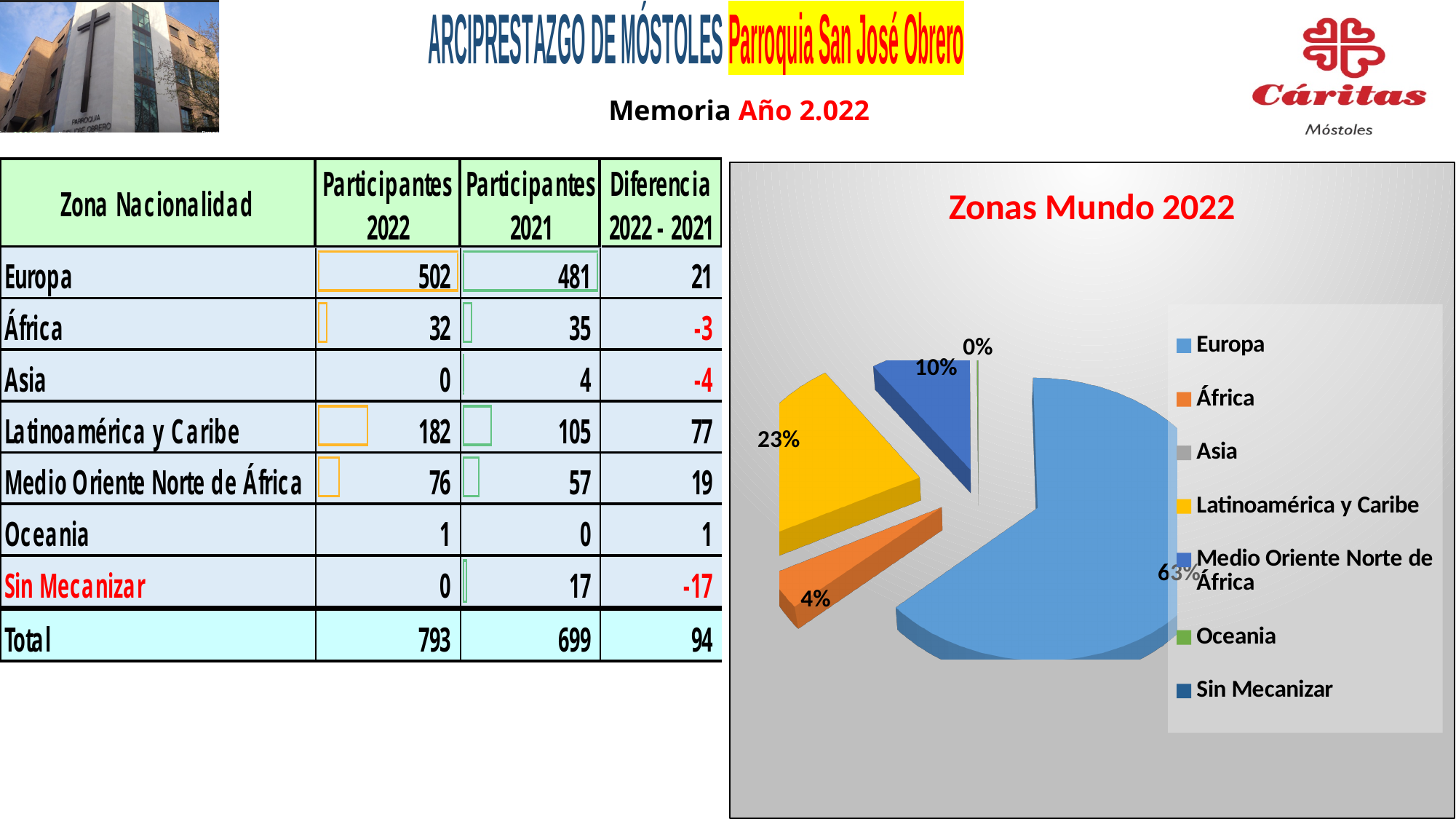
How many entries does the chart legend list? 7 What share of the pie does Europa represent? 63% What is the title of the chart? Zonas Mundo 2022 Which zone has the largest slice of the pie? Europa What share of the pie does Medio Oriente Norte de África represent? 10% Which slice is larger, África or Medio Oriente Norte de África? Medio Oriente Norte de África Which slice is larger, Latinoamérica y Caribe or Medio Oriente Norte de África? Latinoamérica y Caribe What share of the pie does Latinoamérica y Caribe represent? 23% How many percentage points larger is the Latinoamérica y Caribe slice than the Medio Oriente Norte de África slice? 13 What kind of chart is shown on the slide? pie chart How many percentage points larger is the Europa slice than the Latinoamérica y Caribe slice? 40